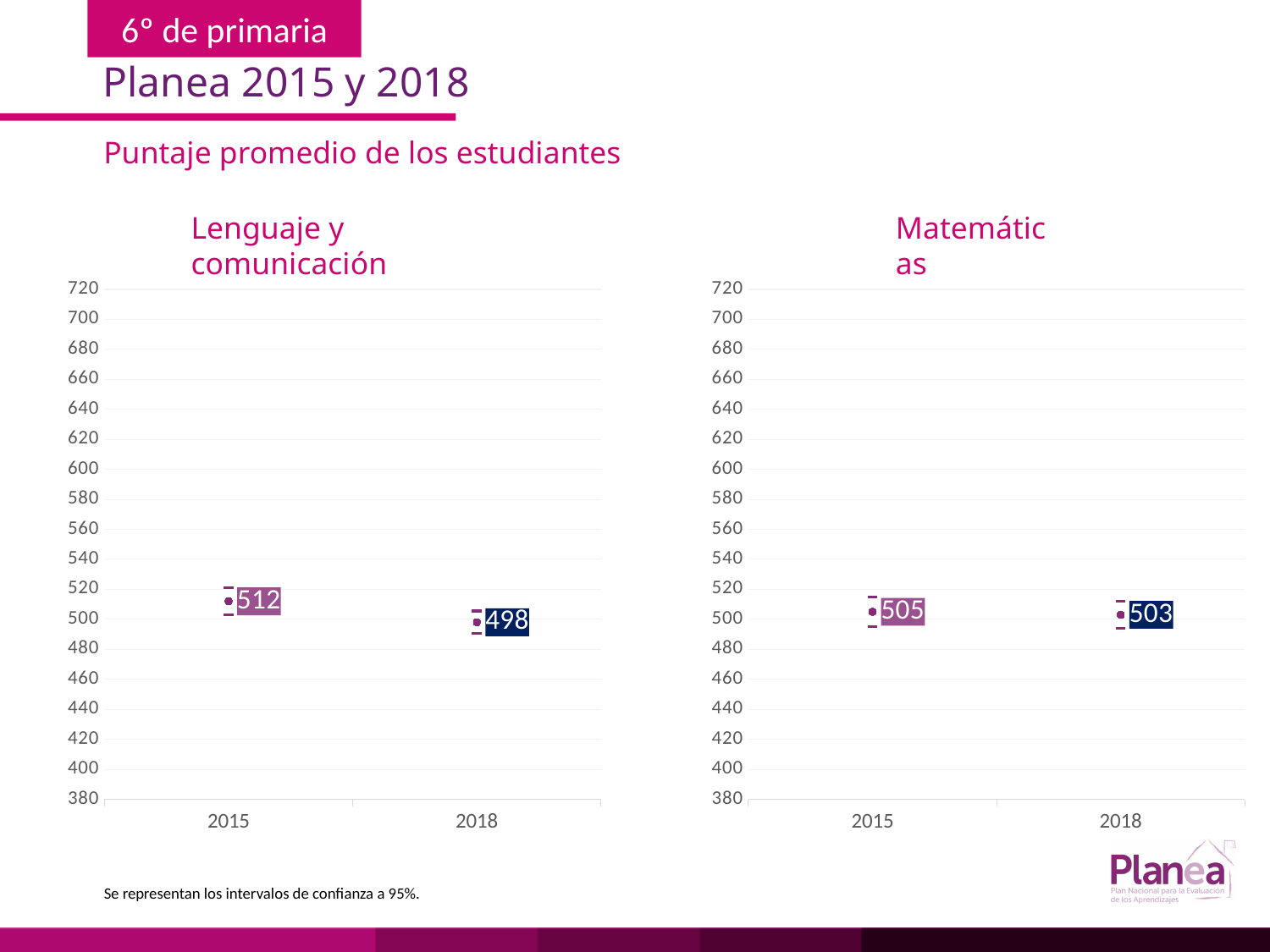
In the 'Lenguaje y comunicación' chart, what is the difference between the 2015 and 2018 scores? 14 What is the title of the chart on the right side of the slide? Matemáticas In the 'Matemáticas' chart, do the scores rise or fall from 2015 to 2018? fall In the 'Lenguaje y comunicación' chart, what is the average score for 2018? 498 In the 'Lenguaje y comunicación' chart, what is the average score for 2015? 512 In the 'Matemáticas' chart, what is the average score for 2015? 505 In the 'Matemáticas' chart, what is the difference between the 2015 and 2018 scores? 2 In the 'Matemáticas' chart, what is the average score for 2018? 503 In the 'Lenguaje y comunicación' chart, do the scores rise or fall from 2015 to 2018? fall In the 'Lenguaje y comunicación' chart, is the 2018 score greater or less than 500? less How many years are plotted in the 'Matemáticas' chart? 2 In the 'Lenguaje y comunicación' chart, which year has the higher score, 2015 or 2018? 2015